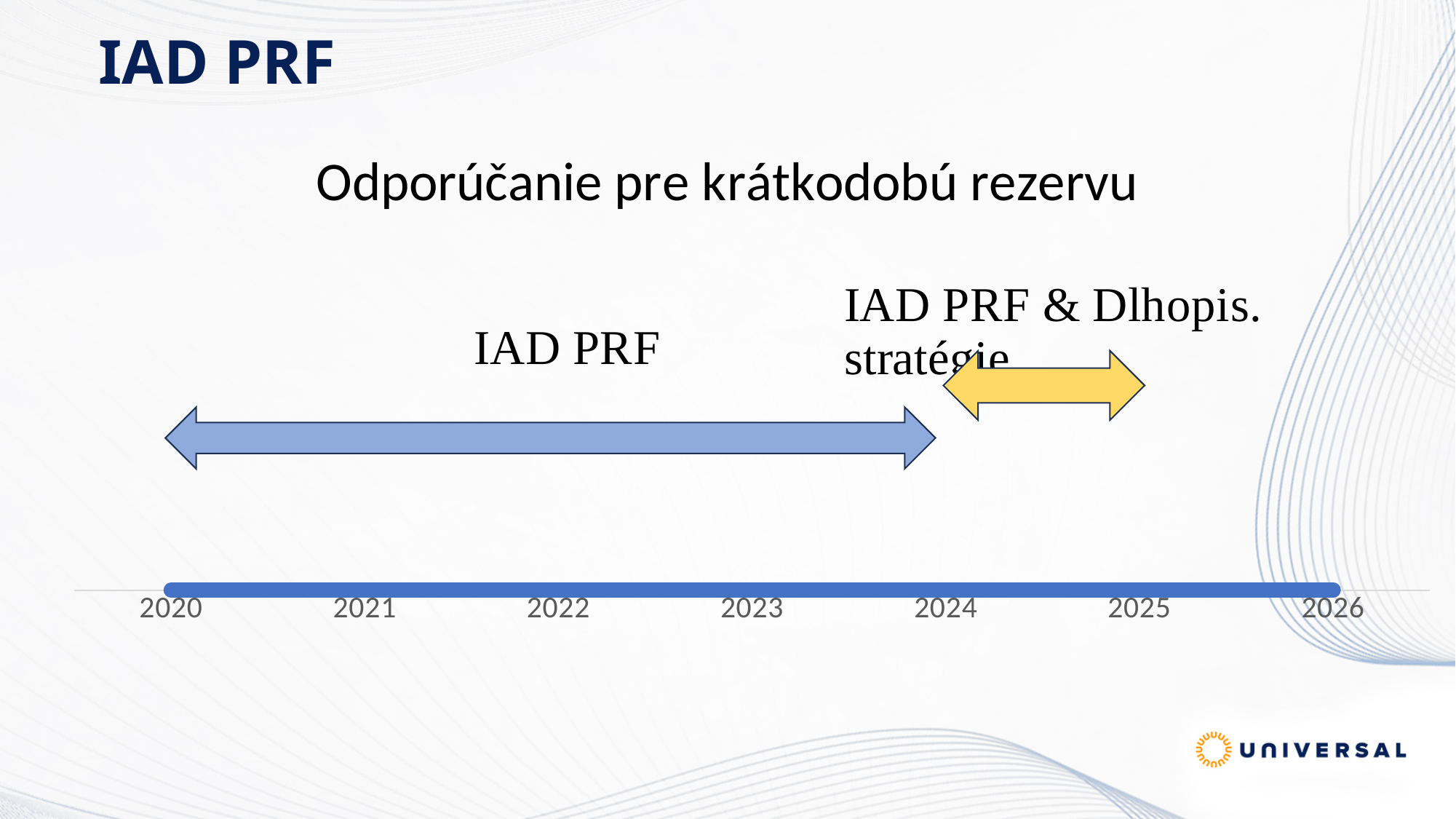
Which arrow on the timeline spans more years, the blue one or the yellow one? the blue one How many year labels are shown along the timeline axis? 7 What is the first year shown on the timeline axis? 2020 What is the title shown above the timeline chart? Odporúčanie pre krátkodobú rezervu What label is written above the blue arrow on the timeline? IAD PRF What is the last year shown on the timeline axis? 2026 Do the year labels on the timeline axis increase or decrease from left to right? increase